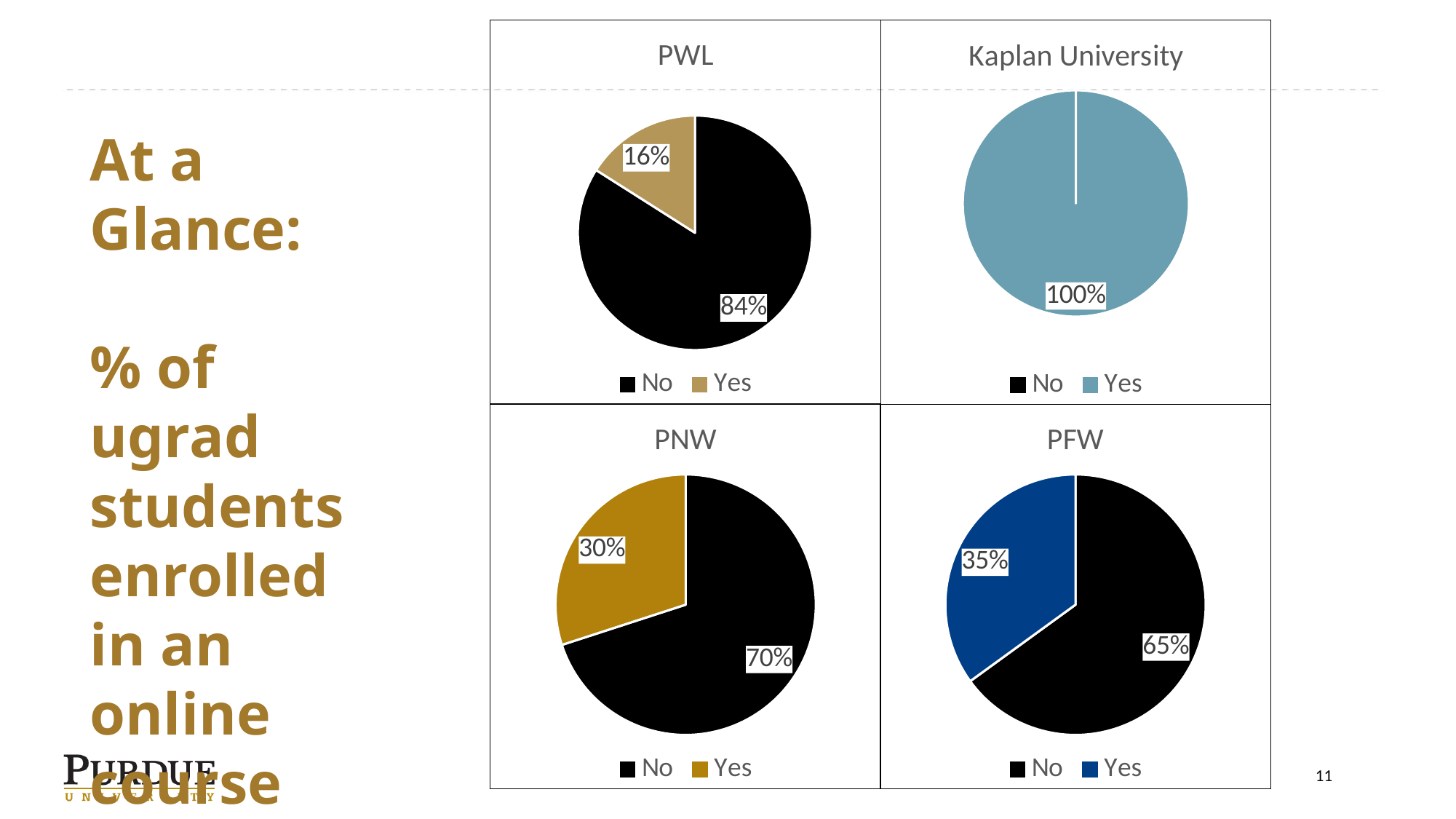
In the Kaplan University chart, what percentage is shown for Yes? 100% What kind of chart is the PFW chart? Pie chart In the PNW chart, which slice is larger, No or Yes? No In the PFW chart, what is the difference between the No and Yes percentages? 30% Which of the four charts shows the lowest percentage for Yes? PWL What colour is the Yes slice in the Kaplan University chart? Light blue Which of the four charts shows the highest percentage for Yes? Kaplan University In the PNW chart, what percentage is shown for Yes? 30% How many entries does the legend of the PNW chart list? 2 In the PFW chart, what percentage is shown for No? 65% In the PWL chart, what percentage is shown for No? 84% In the PWL chart, what percentage of undergraduate students are enrolled in an online course (Yes)? 16%